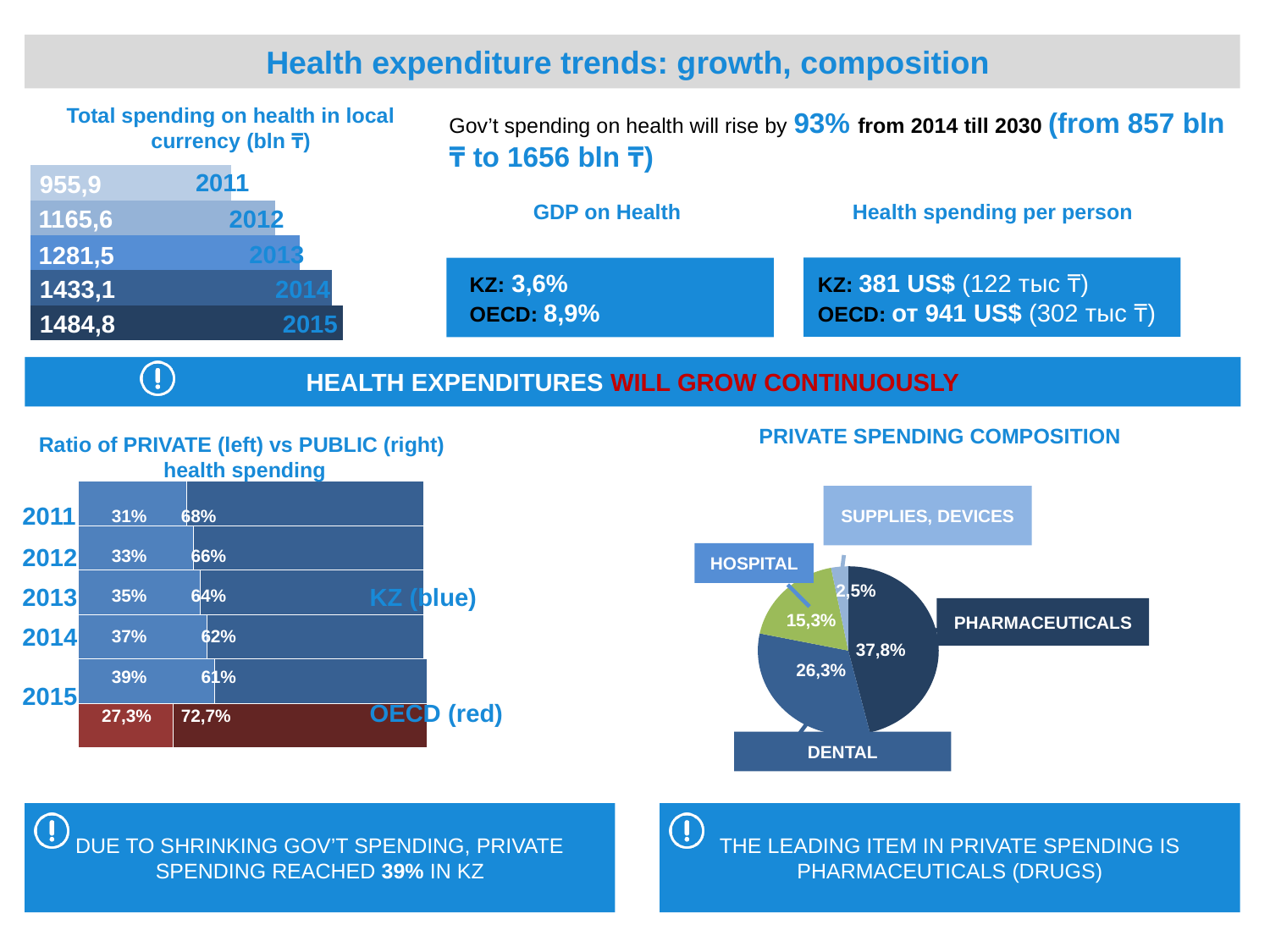
In the 'Ratio of PRIVATE vs PUBLIC health spending' chart, which is larger: the private share for 2011 or the private share for 2015? 2015 In the 'Total spending on health in local currency' chart, what is the value for 2011? 955,9 In the 'Total spending on health in local currency' chart, how many years are shown? 5 In the 'Total spending on health in local currency' chart, which year has the lowest value? 2011 In the 'Total spending on health in local currency' chart, what is the value for 2015? 1484,8 In the 'Total spending on health in local currency' chart, what kind of chart is it? bar chart In the 'PRIVATE SPENDING COMPOSITION' pie chart, what is the share for PHARMACEUTICALS? 37,8% In the 'Ratio of PRIVATE vs PUBLIC health spending' chart, what is the public share for OECD? 72,7% In the 'PRIVATE SPENDING COMPOSITION' pie chart, what is the share for DENTAL? 26,3% In the 'Total spending on health in local currency' chart, which year has the highest value? 2015 In the 'Ratio of PRIVATE vs PUBLIC health spending' chart, what is the private share for 2015? 39% In the 'Total spending on health in local currency' chart, do the values rise or fall from 2011 to 2015? rise